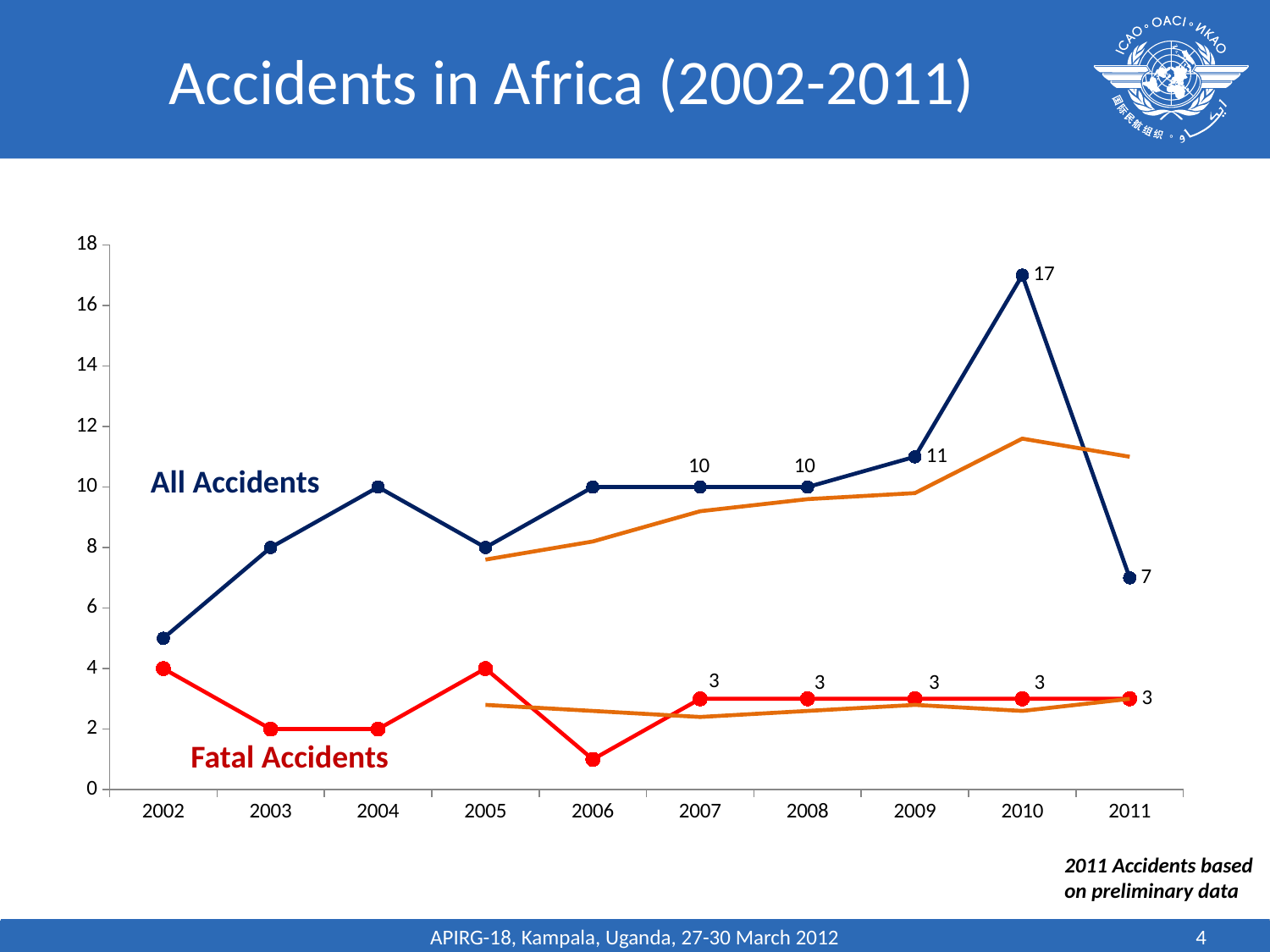
In which year is the Fatal Accidents value lowest? 2006 What is the difference between All Accidents in 2010 and All Accidents in 2011? 10 Does the All Accidents line rise or fall from 2010 to 2011? Fall Which is larger, All Accidents in 2009 or All Accidents in 2011? All Accidents in 2009 What is the value for All Accidents in 2011? 7 In which year is the All Accidents value highest? 2010 What kind of chart is shown on the slide? Line chart What is the difference between All Accidents and Fatal Accidents in 2009? 8 How many years are shown on the x axis? 10 What is the value for All Accidents in 2010? 17 What is the value for Fatal Accidents in 2009? 3